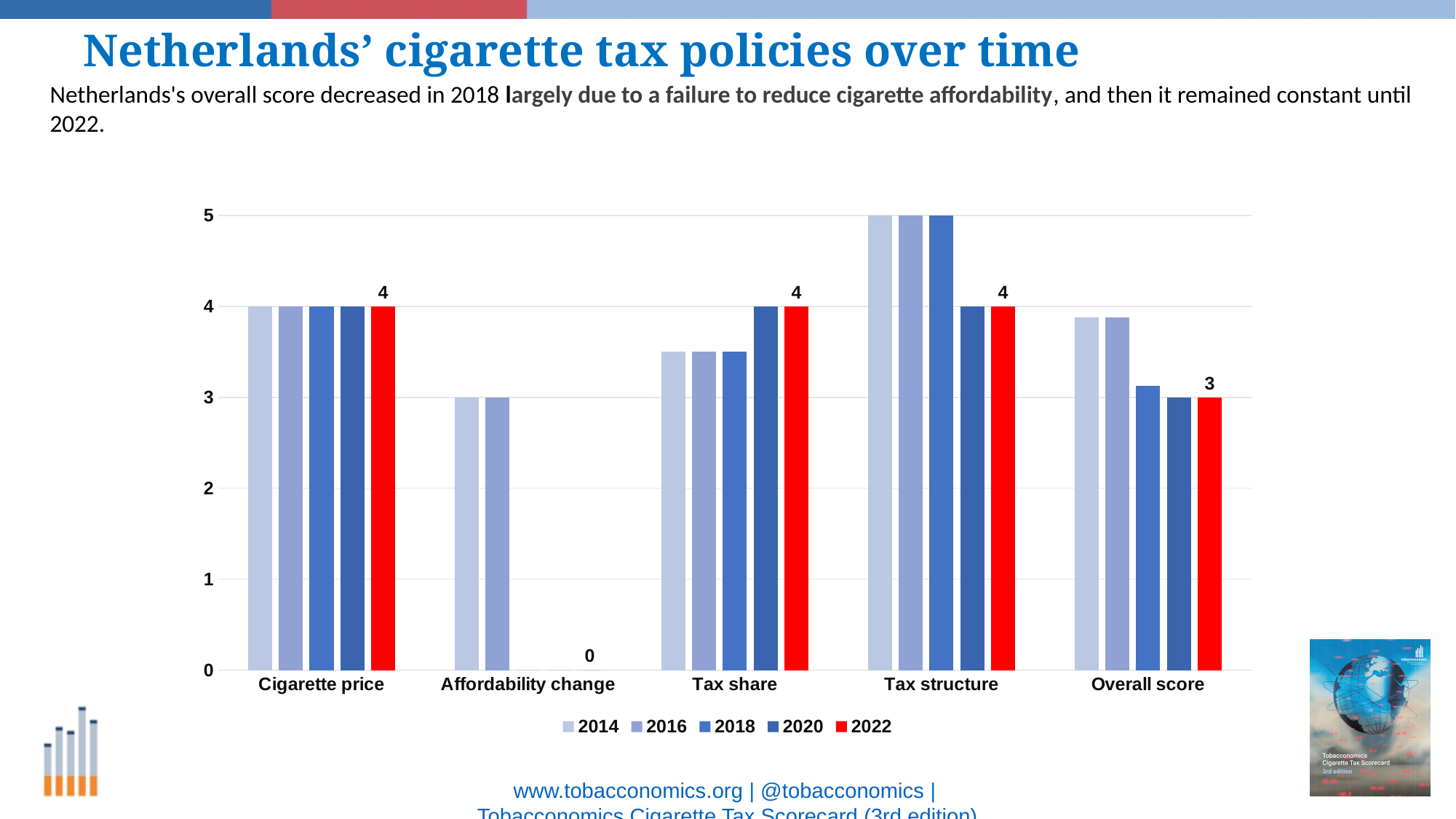
Which category has the lowest 2022 value? Affordability change What is the 2020 value for Tax structure? 4 Which is larger for Tax structure: the 2014 value or the 2022 value? 2014 How many categories are shown on the x axis? 5 Is the 2014 value for Overall score greater or less than 3? greater What is the 2022 value for Overall score? 3 What is the 2022 value for Cigarette price? 4 What is the 2022 value for Affordability change? 0 Is the 2014 value for Tax share greater or less than 4? less What kind of chart is shown on the slide? bar chart What is the difference between the 2022 values for Cigarette price and Overall score? 1 How many series does the legend list? 5